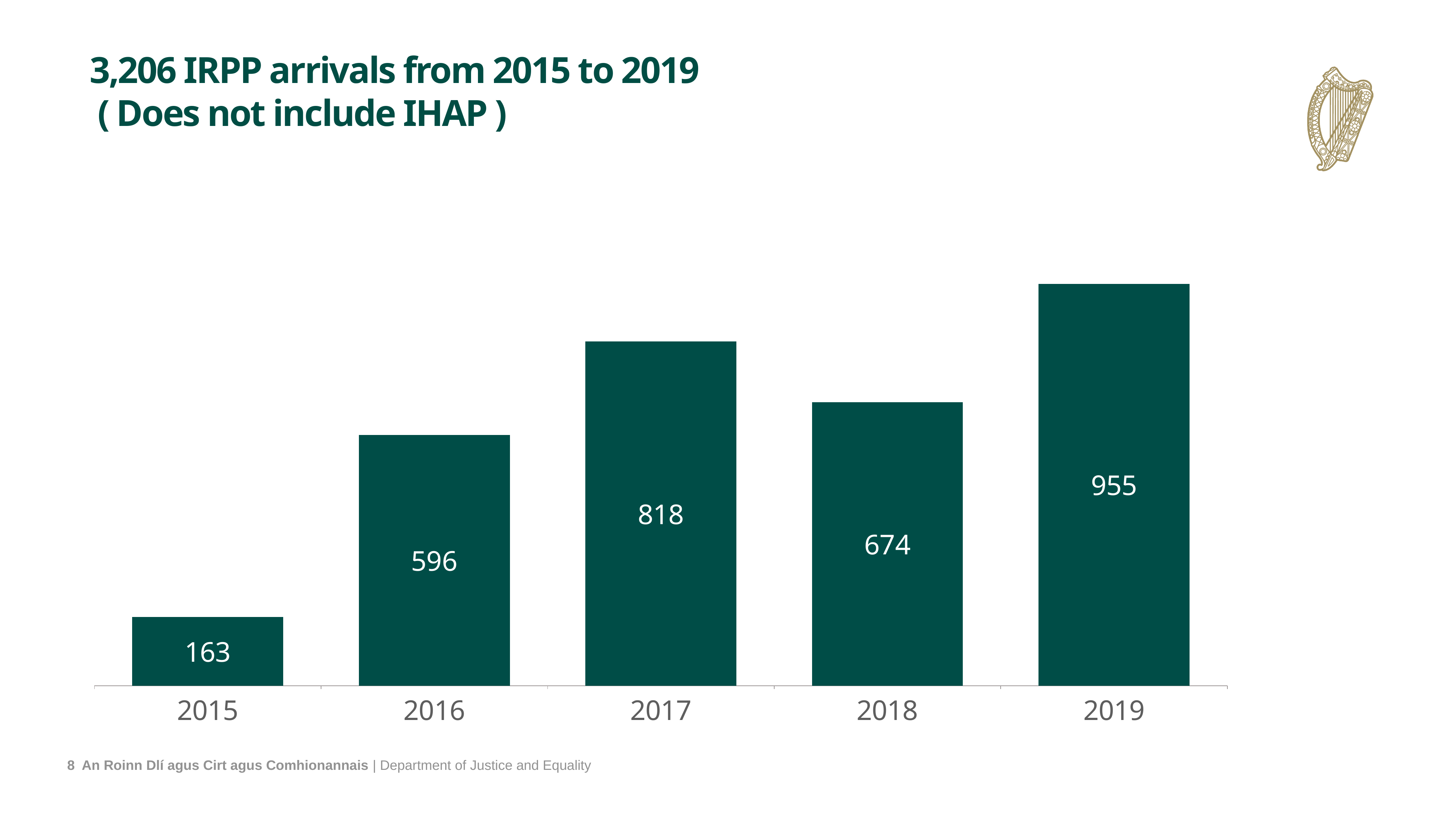
Which year has the highest value? 2019 What is the value for 2017? 818 What is the difference between the values for 2016 and 2015? 433 What is the value for 2015? 163 Does the value rise or fall from 2017 to 2018? fall Which year has the lowest value? 2015 Which is larger, the value for 2017 or the value for 2018? 2017 How many years are shown on the chart? 5 What is the difference between the values for 2019 and 2018? 281 What kind of chart is shown on the slide? bar chart What is the value for 2019? 955 What is the title of the slide? 3,206 IRPP arrivals from 2015 to 2019 ( Does not include IHAP )